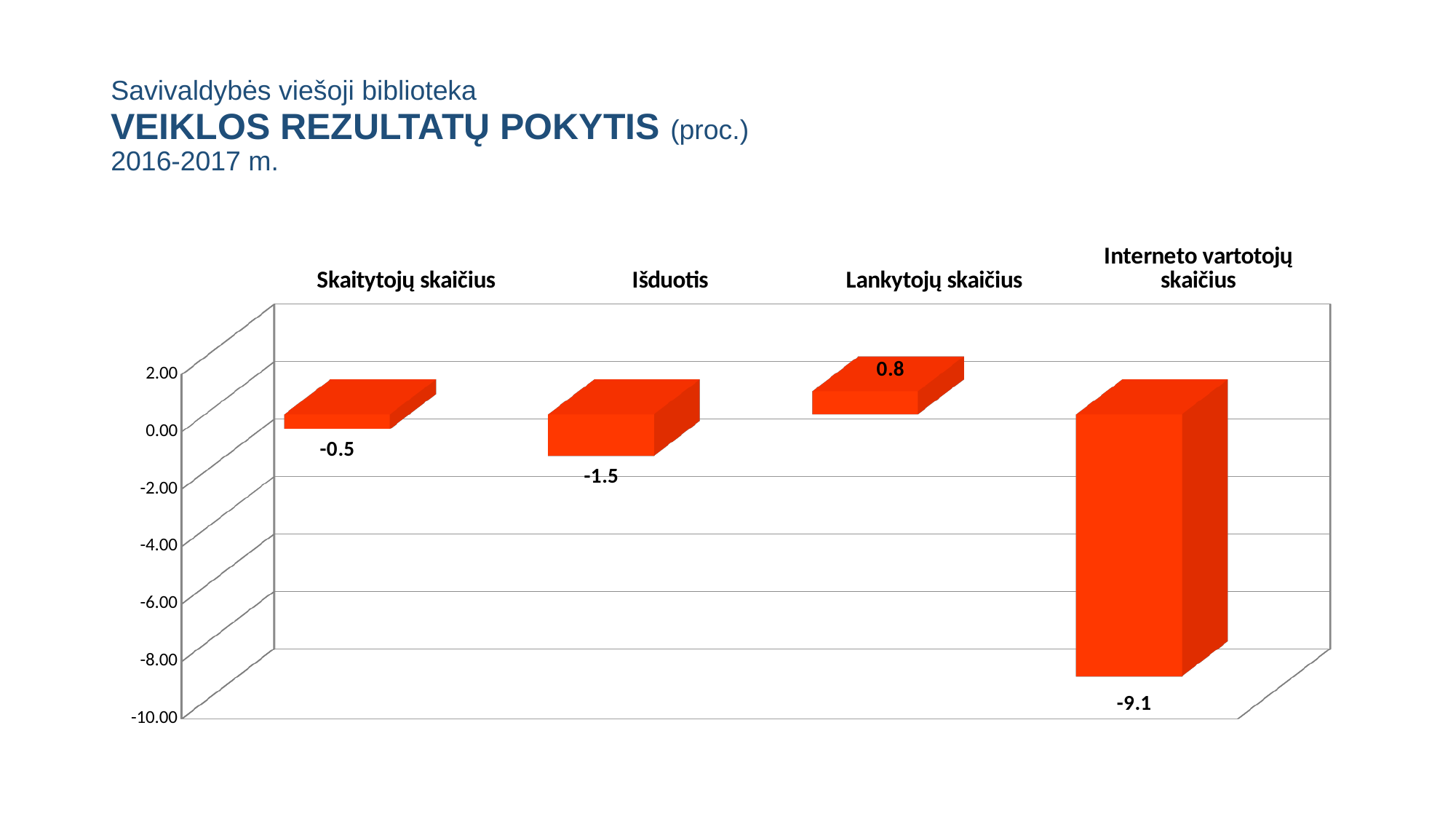
What kind of chart is shown on the slide? Bar chart What is the value for Lankytojų skaičius? 0.8 What is the value for Interneto vartotojų skaičius? -9.1 What is the value for Skaitytojų skaičius? -0.5 Which years does the chart title say the change covers? 2016-2017 m. How many categories are shown in the chart? 4 What is the difference between the values for Lankytojų skaičius and Interneto vartotojų skaičius? 9.9 Which category has the lowest value? Interneto vartotojų skaičius Which is larger, the value for Skaitytojų skaičius or the value for Išduotis? Skaitytojų skaičius What is the difference between the values for Skaitytojų skaičius and Išduotis? 1.0 What is the value for Išduotis? -1.5 Which category has the highest value? Lankytojų skaičius